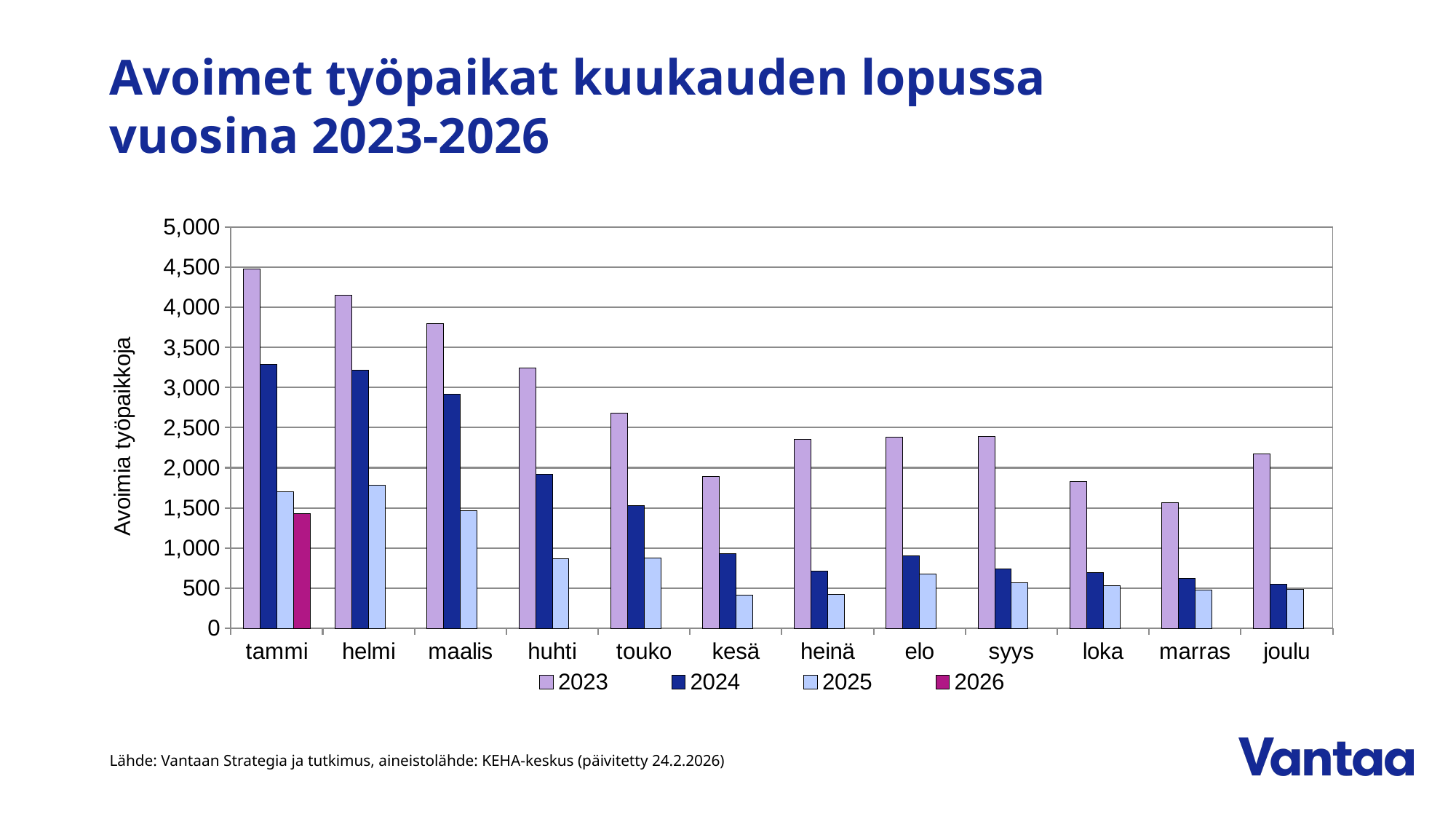
What is the title of the y axis? Avoimia työpaikkoja For helmi, which series has the larger value, 2023 or 2024? 2023 Do the 2024 values generally rise or fall from tammi to joulu? fall Is the 2026 value for tammi greater or less than 1,000? greater In which month is the 2023 value highest? tammi In which month is the 2024 value lowest? joulu Is the 2024 value for huhti greater or less than 2,000? less How many months are shown on the x axis? 12 How many series does the legend list? 4 What kind of chart is shown on the slide? bar chart Is the 2023 value for tammi greater or less than 4,000? greater For 2023, which month has the larger value, marras or joulu? joulu